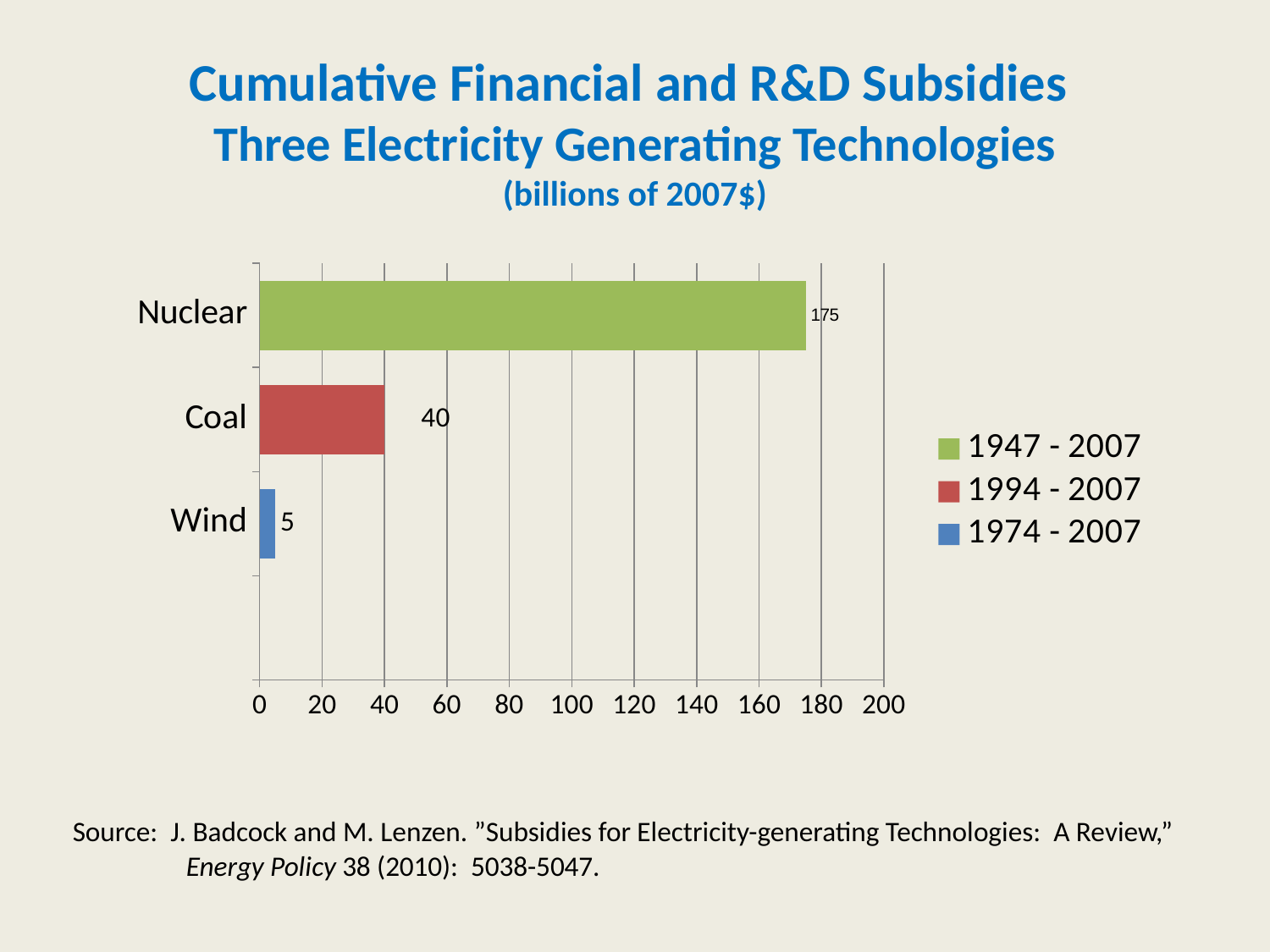
Is the value for Nuclear greater or less than 160? greater Which technology has the highest cumulative subsidies? Nuclear How many technologies are shown in the chart? 3 Which technology has the lowest cumulative subsidies? Wind How many entries does the legend list? 3 What is the value for Nuclear? 175 What is the value for Wind? 5 What kind of chart is shown on the slide? bar chart What is the value for Coal? 40 What is the difference between the values for Coal and Wind? 35 What is the difference between the values for Nuclear and Coal? 135 Which is larger, the value for Coal or the value for Wind? Coal